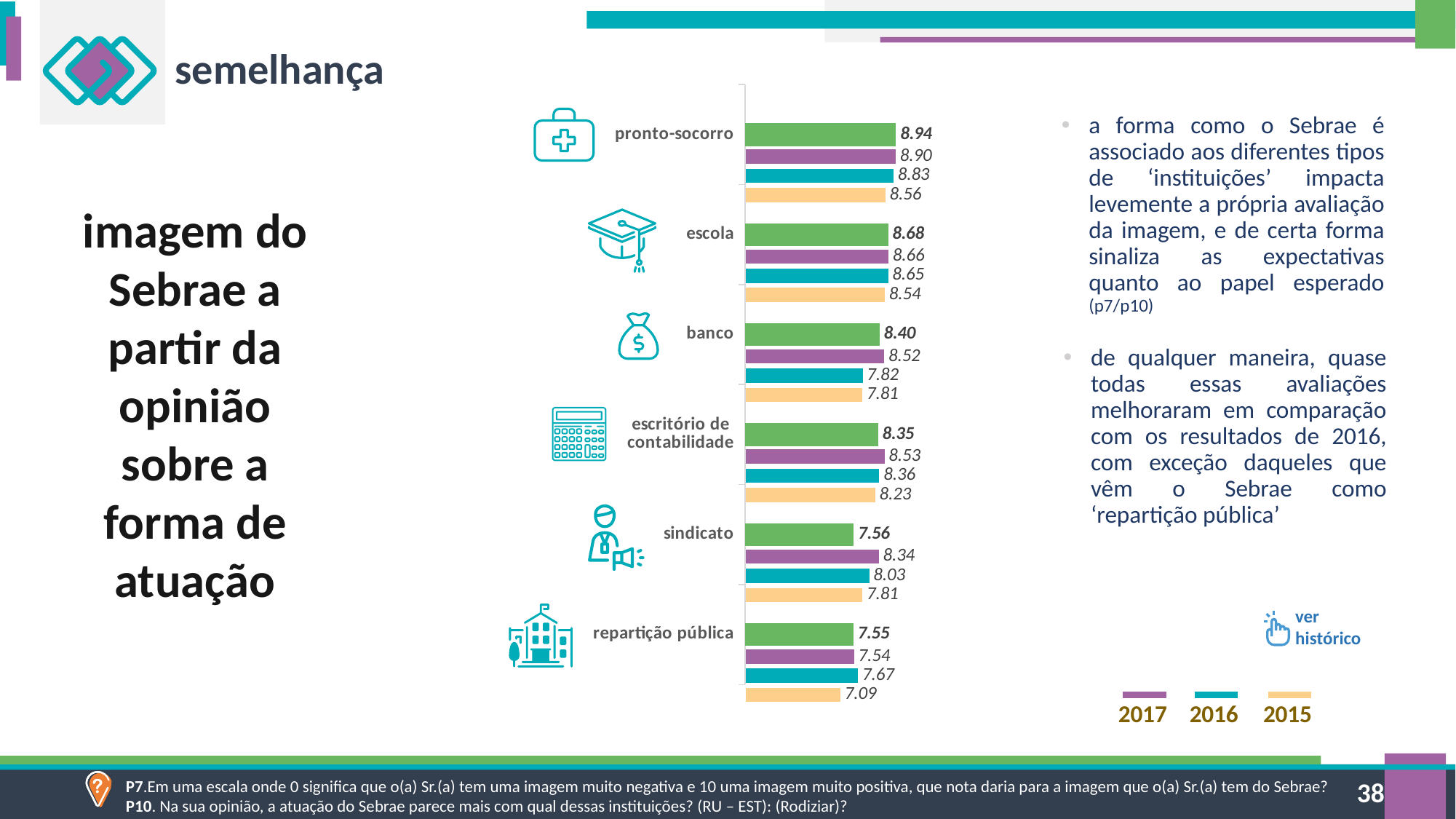
For escritório de contabilidade, which is larger: the 2017 value or the 2016 value? 2017 What are the entries in the chart legend? 2017, 2016, 2015 What value is shown on the green (top) bar for escola? 8.68 Which category has the lowest 2015 value? repartição pública What kind of chart is shown on the slide? bar chart What is the 2016 value for sindicato? 8.03 What is the 2015 value for repartição pública? 7.09 Which category has the highest 2017 value? pronto-socorro What is the 2017 value for banco? 8.52 What is the difference between the 2017 and 2015 values for sindicato? 0.53 How many categories (institution types) are shown in the chart? 6 How many series does the legend list? 3